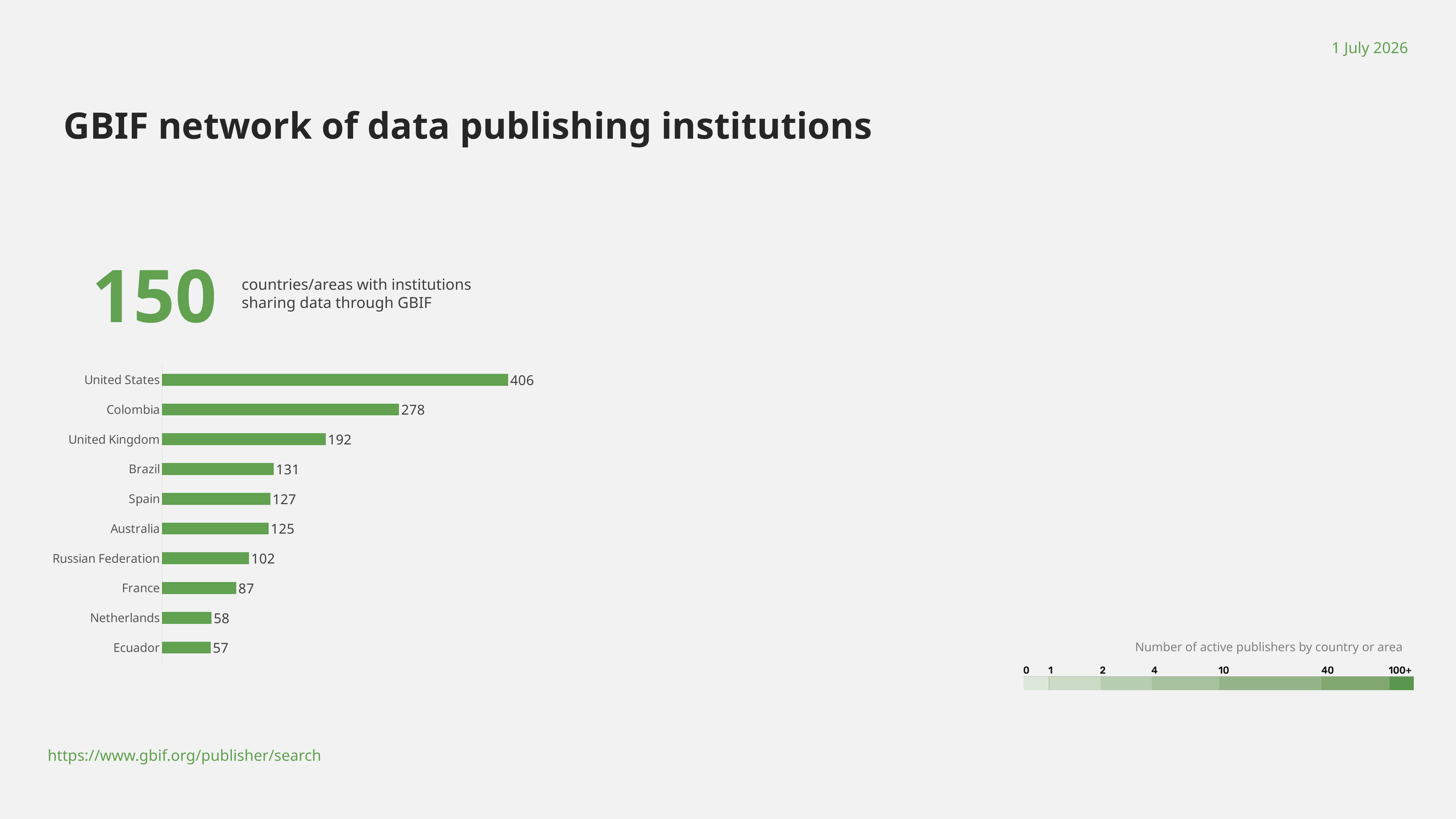
How many countries are shown in the bar chart? 10 What is the difference between the values for United Kingdom and Brazil? 61 What colour are the bars in the chart? Green What is the difference between the values for United States and Colombia? 128 Which has a larger value, Spain or France? Spain What is the value for Russian Federation? 102 Which country has the lowest value? Ecuador What is the value for United States? 406 What is the value for Netherlands? 58 Which country has the highest value? United States What kind of chart is shown on the slide? Bar chart What is the value for Colombia? 278